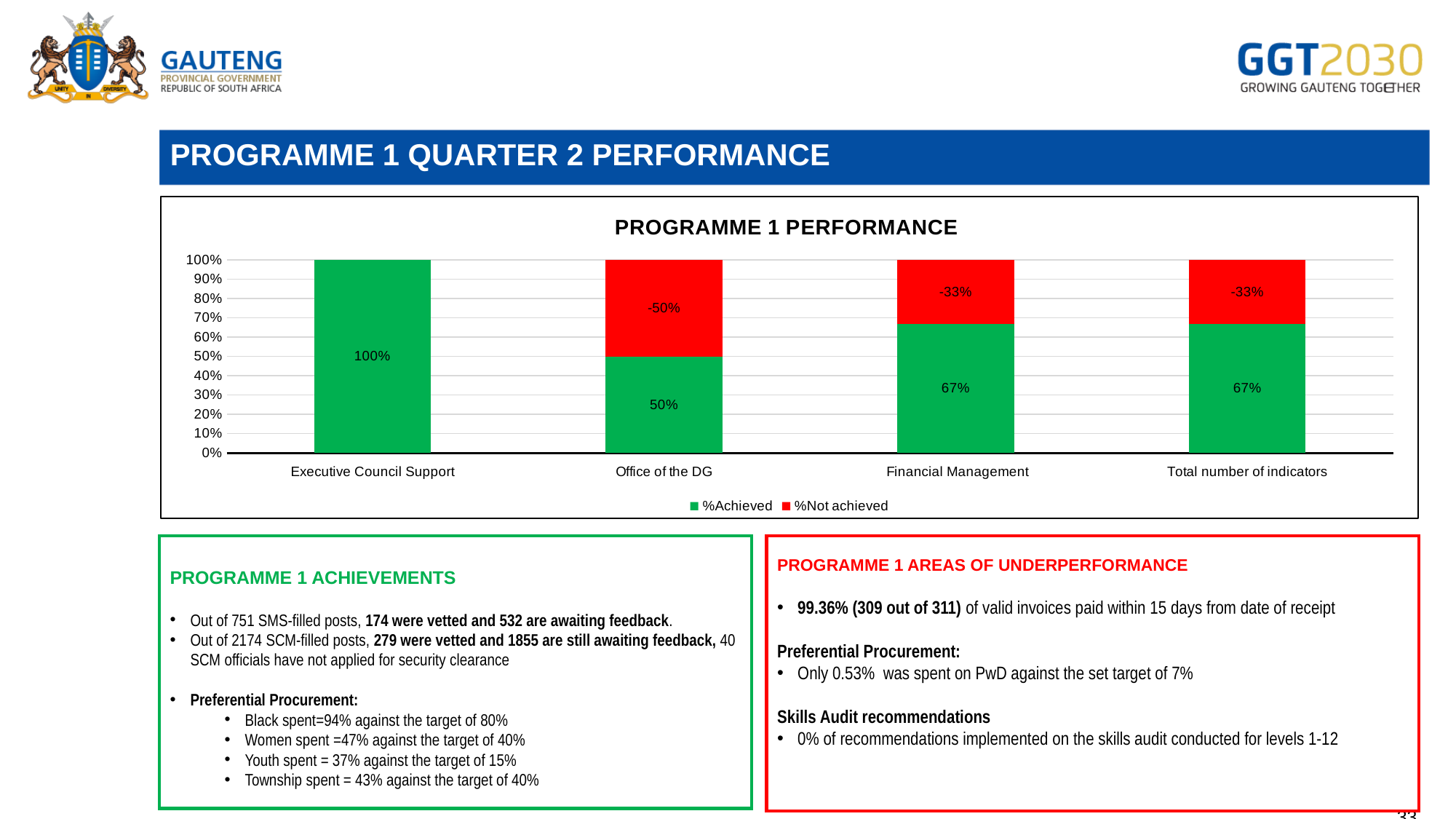
What is the %Achieved value for Executive Council Support? 100% Which has a larger %Achieved value, Financial Management or Office of the DG? Financial Management What label is shown on the %Not achieved segment for Office of the DG? -50% What is the %Achieved value for Total number of indicators? 67% Which category has the highest %Achieved value? Executive Council Support What is the %Achieved value for Office of the DG? 50% What type of chart is shown on the slide? Stacked bar chart Which category has the lowest %Achieved value? Office of the DG How many series does the legend list? 2 How many categories are shown on the x axis of the chart? 4 What is the difference in %Achieved between Executive Council Support and Office of the DG? 50% What label is shown on the %Not achieved segment for Financial Management? -33%